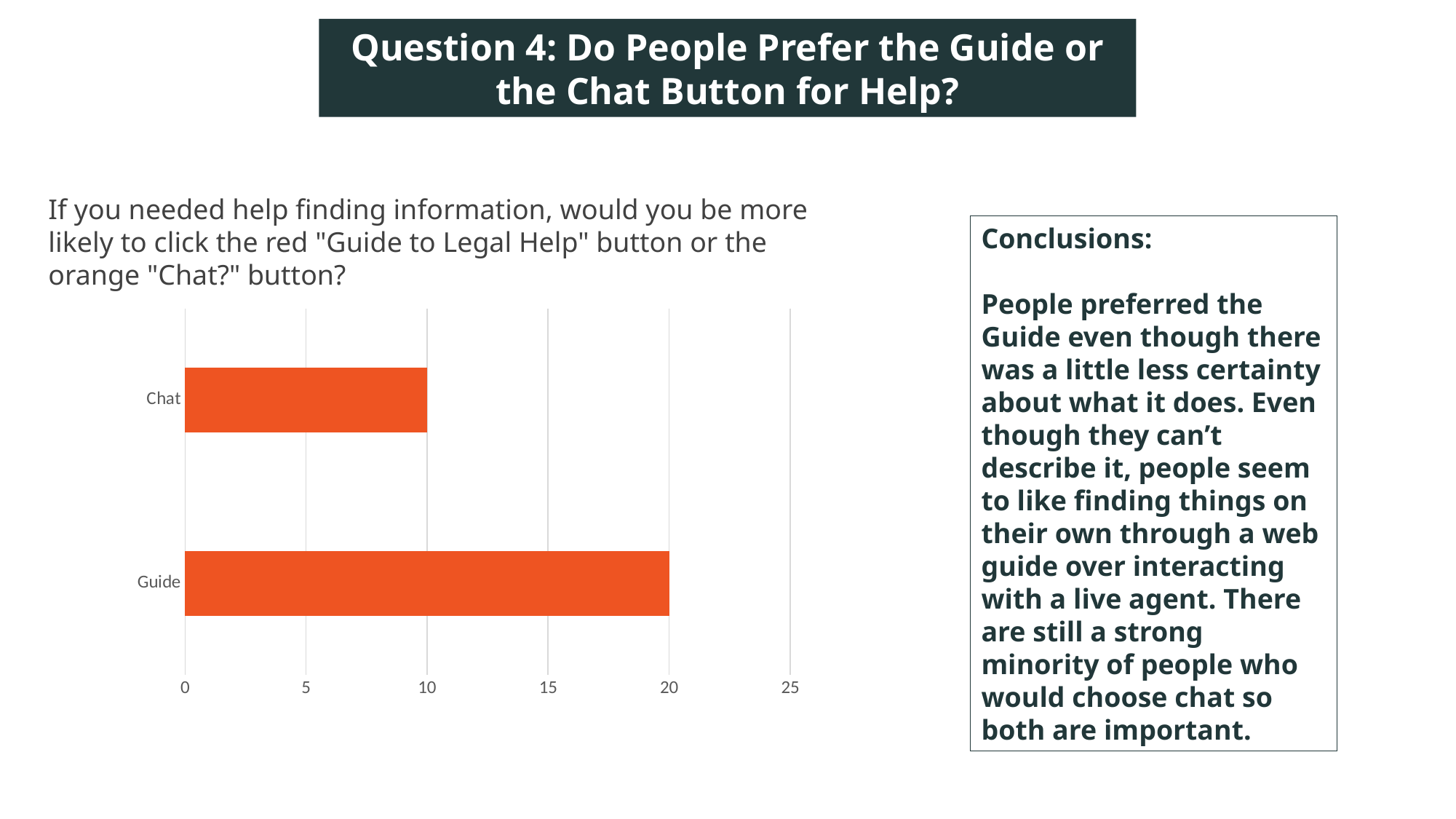
What is the value for Chat? 10 What is the highest value shown on the horizontal axis? 25 What colour are the bars in the chart? orange What is the difference between the value for Guide and the value for Chat? 10 Which is larger, the value for Guide or the value for Chat? Guide How many categories does the bar chart show? 2 Is the value for Chat greater or less than 15? less What is the value for Guide? 20 Which category has the highest value? Guide Which category has the lowest value? Chat What kind of chart is shown on the slide? bar chart Is the value for Guide greater or less than 15? greater